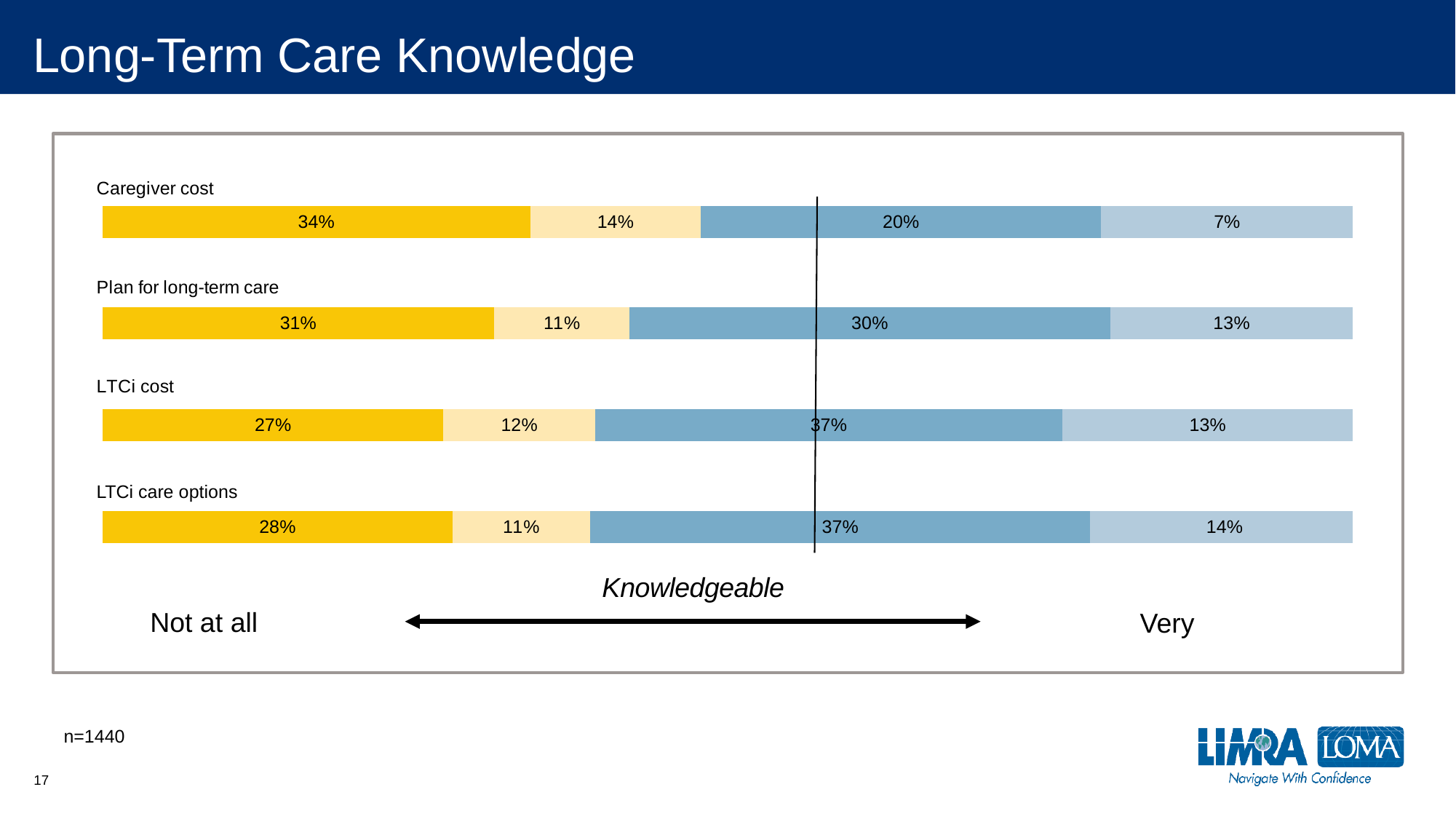
Which category has the highest value in the leftmost 'Not at all' segment? Caregiver cost What is the value of the leftmost (dark yellow, 'Not at all') segment for Caregiver cost? 34% What labels appear at the two ends of the 'Knowledgeable' scale below the chart? Not at all and Very What is the total of the four labelled segments in the Caregiver cost bar? 75% Which is larger: the medium blue segment for Plan for long-term care or the medium blue segment for LTCi care options? LTCi care options What is the value of the medium blue (third) segment for LTCi cost? 37% What kind of chart is shown on the slide? Stacked bar chart What is the difference between the 'Not at all' segment for Caregiver cost and the 'Not at all' segment for LTCi cost? 7 percentage points Which category has the lowest value in the rightmost 'Very' segment? Caregiver cost How many categories (bars) are shown in the chart? 4 What is the value of the light yellow (second) segment for LTCi care options? 11% What is the value of the rightmost (light blue, 'Very') segment for Plan for long-term care? 13%